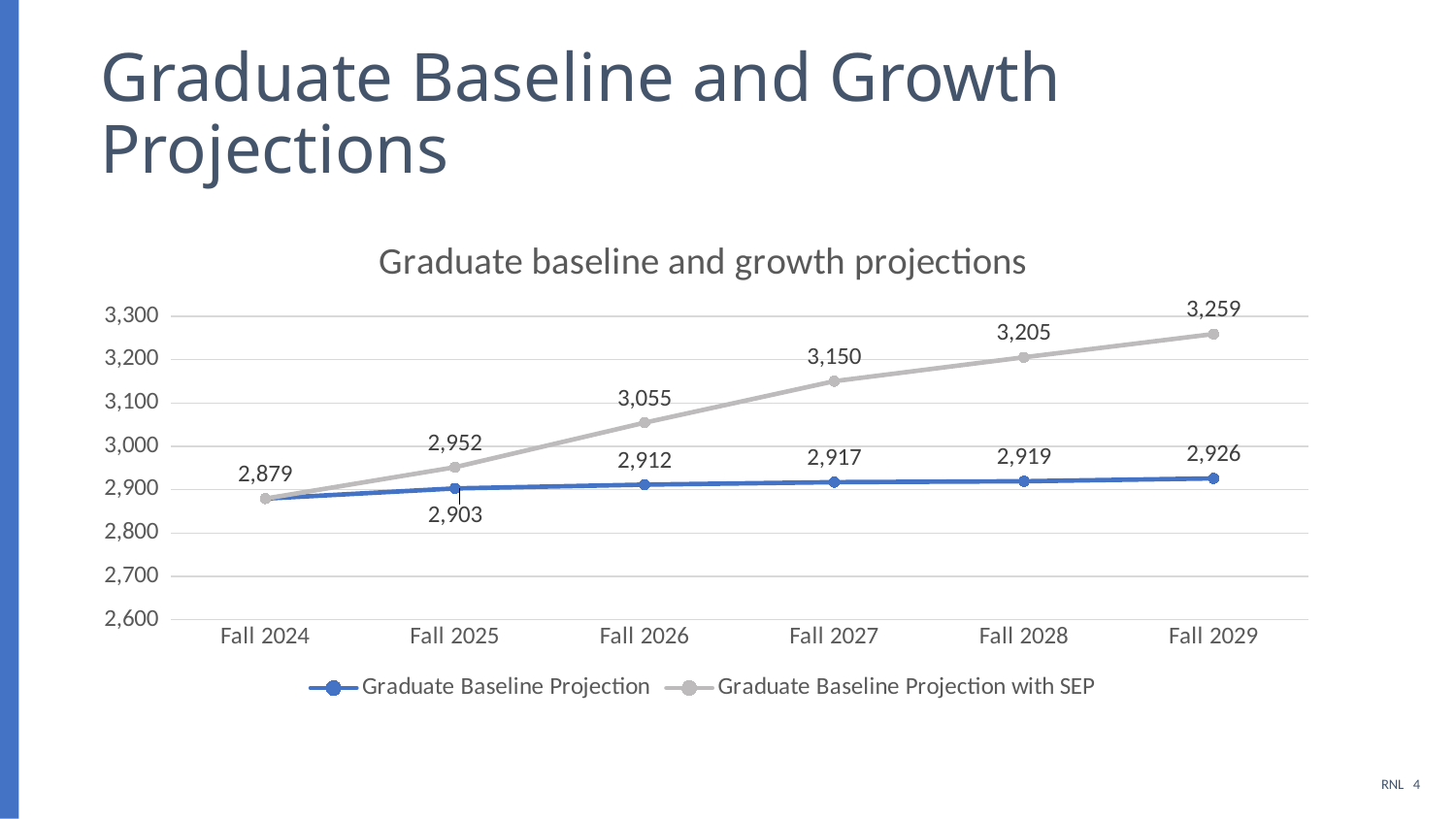
What is the title of the chart? Graduate baseline and growth projections Is the Graduate Baseline Projection with SEP value for Fall 2026 greater or less than 3,000? greater In which year does the Graduate Baseline Projection with SEP reach its highest value? Fall 2029 How many points are plotted along the x axis for each series? 6 What is the Graduate Baseline Projection with SEP value for Fall 2028? 3,205 What kind of chart is shown on the slide? Line chart Do the Graduate Baseline Projection with SEP values rise or fall from Fall 2024 to Fall 2029? Rise What is the Graduate Baseline Projection value for Fall 2025? 2,903 How many series does the legend list? 2 What is the Graduate Baseline Projection value for Fall 2026? 2,912 Which series has the larger value in Fall 2027? Graduate Baseline Projection with SEP What is the difference between the Graduate Baseline Projection with SEP and the Graduate Baseline Projection in Fall 2029? 333